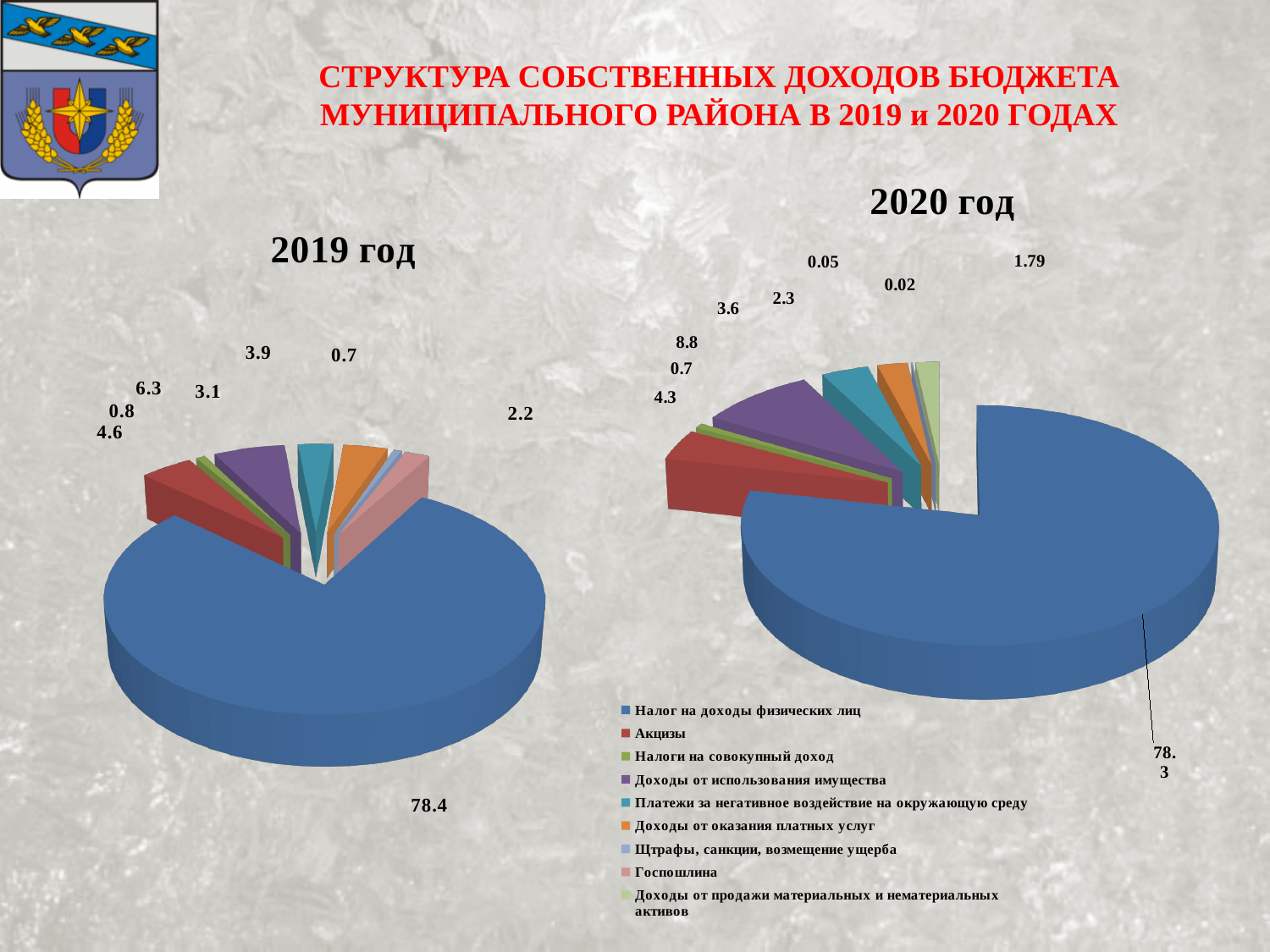
What is the smallest value labelled on the 2020 год chart? 0.02 What kind of chart is used for the 2019 год chart? pie chart What colour represents Акцизы in the legend? red How many categories does the legend list? 9 Is the Налог на доходы физических лиц value larger on the 2019 год chart or on the 2020 год chart? 2019 год What is the largest value labelled on the 2019 год chart? 78.4 Which category has the largest slice on the 2020 год chart? Налог на доходы физических лиц On the 2019 год chart, what is the value for Налог на доходы физических лиц? 78.4 On the 2020 год chart, what is the value for Налог на доходы физических лиц? 78.3 What is the title of the slide? СТРУКТУРА СОБСТВЕННЫХ ДОХОДОВ БЮДЖЕТА МУНИЦИПАЛЬНОГО РАЙОНА В 2019 и 2020 ГОДАХ What is the difference between the Налог на доходы физических лиц value on the 2019 год chart and on the 2020 год chart? 0.1 Which category has the largest slice on the 2019 год chart? Налог на доходы физических лиц